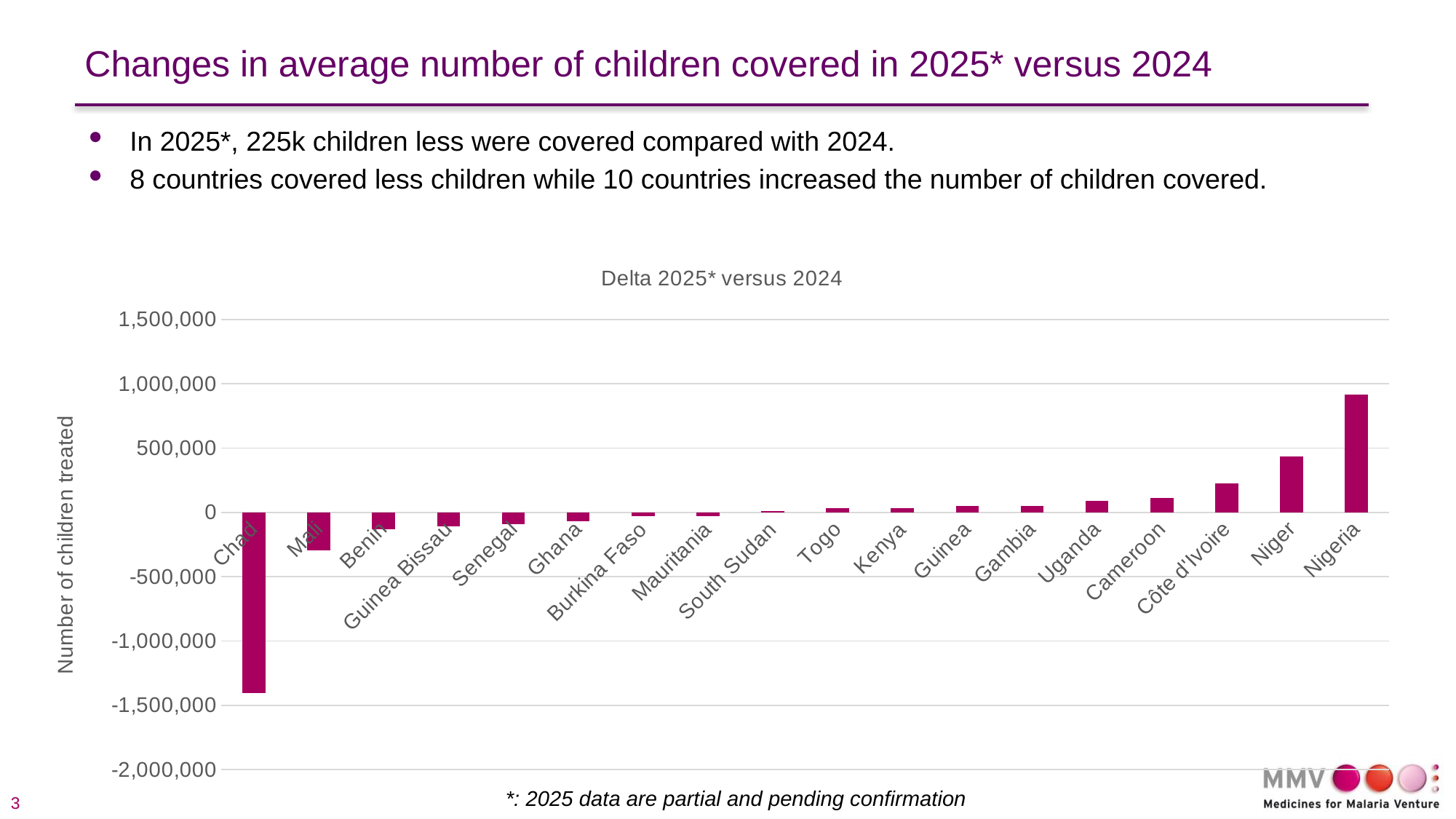
What is the title of the chart? Delta 2025* versus 2024 What kind of chart is shown on the slide? bar chart Is the value for Niger greater or less than 500,000? less How many countries are shown on the x axis of the chart? 18 Do the values generally rise or fall moving from left to right along the x axis? rise Is the value for Chad greater or less than -1,000,000? less Which country has the highest value in the chart? Nigeria Which has the larger value, Niger or Côte d'Ivoire? Niger Is the value for Mali greater or less than -500,000? greater What is the label of the vertical axis? Number of children treated Which country has the lowest value in the chart? Chad